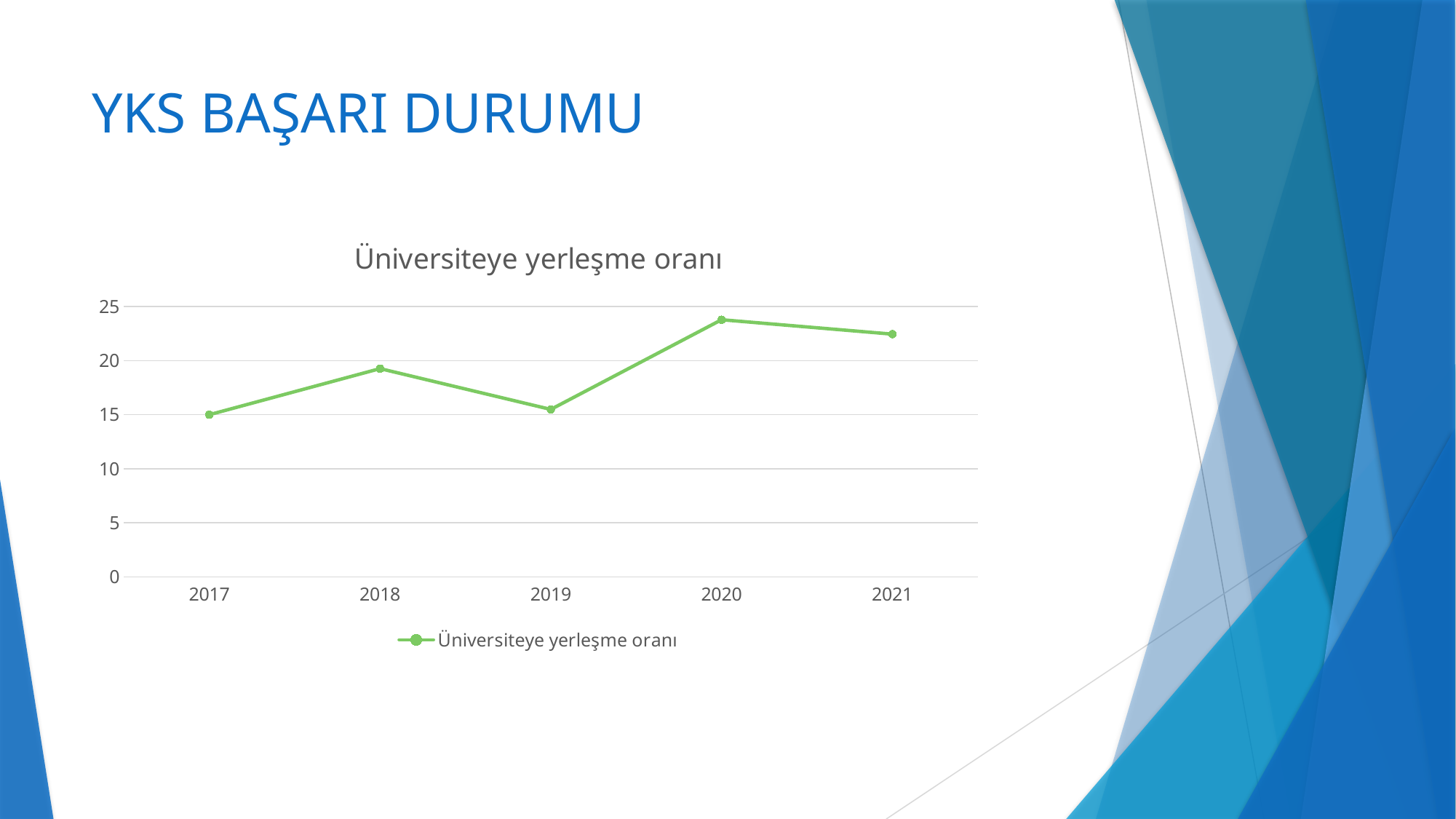
Is the value for 2021 greater or less than 20? greater Which year has the larger value, 2018 or 2019? 2018 What is the title of the chart? Üniversiteye yerleşme oranı How many series does the legend list? 1 What type of chart is shown on the slide? line chart Which year has the highest value for Üniversiteye yerleşme oranı? 2020 Is the value for 2018 greater or less than 20? less Is the value for 2019 greater or less than 20? less Which year has the larger value, 2017 or 2021? 2021 Overall, does the value rise or fall from 2017 to 2021? rise How many years are plotted on the x axis? 5